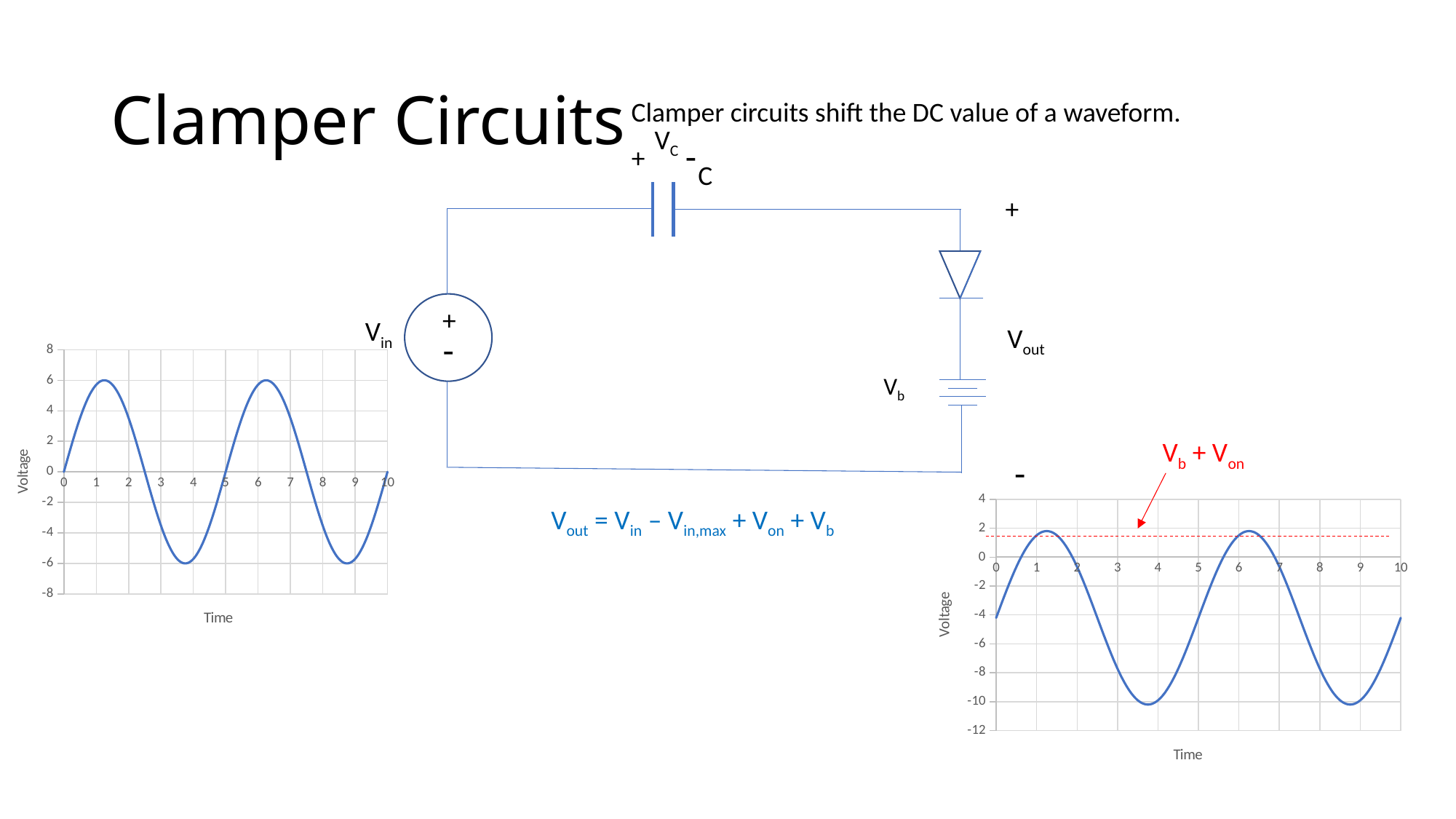
Which chart has the higher peak voltage, the left chart or the right chart? the left chart What is the x-axis label on the left chart? Time On the left chart, what is the voltage value at time 0? 0 On the right chart, is the voltage at time 0 greater or less than -2? less On the right chart, is the peak voltage greater or less than 4? less On the right chart, is the minimum voltage greater or less than -8? less On the left chart, what is the voltage value at time 10? 0 What label is attached to the red dashed line on the right chart? Vb + Von What kind of chart is the left chart (Voltage vs Time, y-axis from -8 to 8)? line chart What kind of chart is the right chart (Voltage vs Time, y-axis from -12 to 4)? line chart